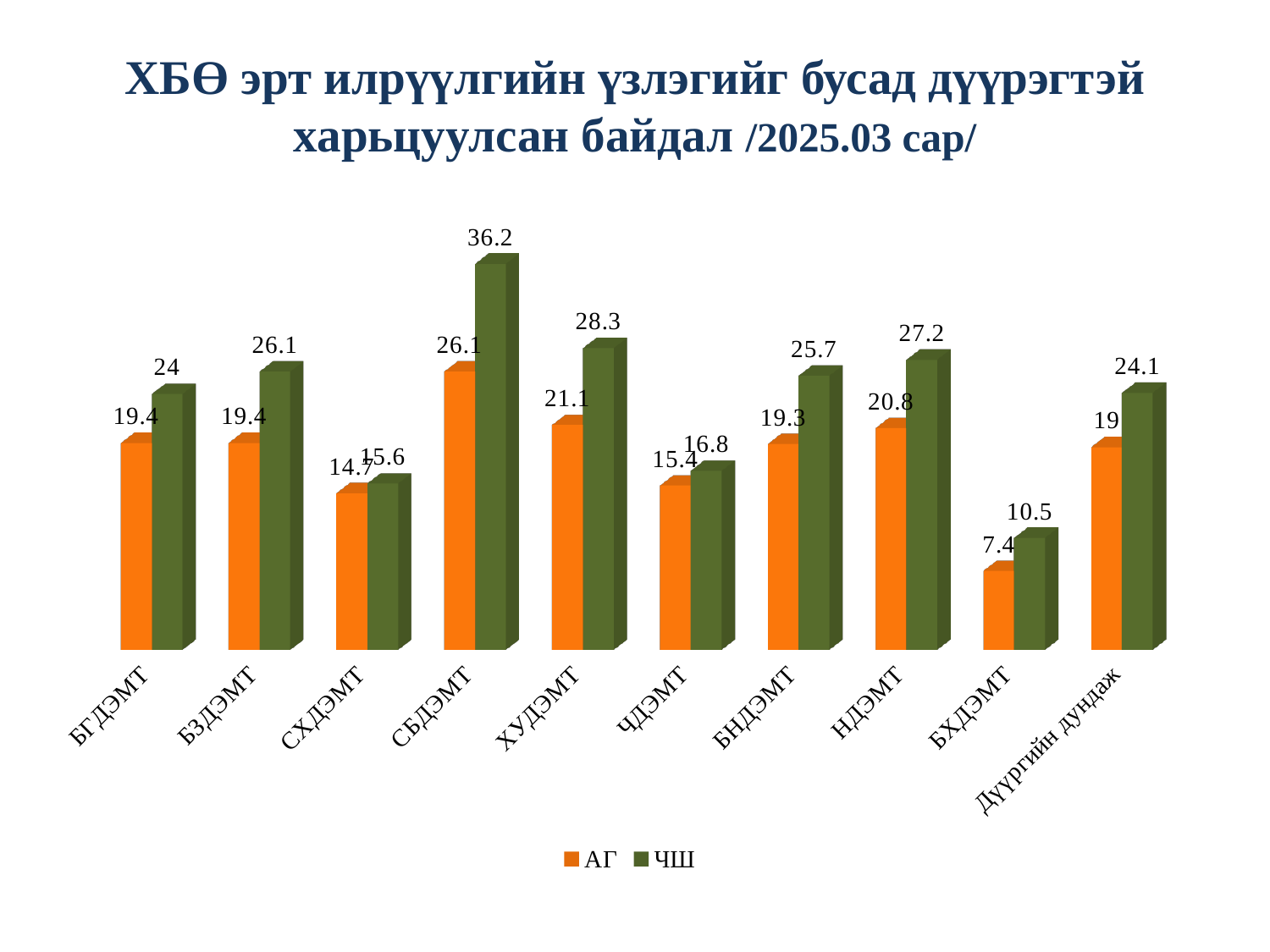
What is the difference between the ЧШ values for ХУДЭМТ and БХДЭМТ? 17.8 Which series is shown in orange? АГ What is the ЧШ value for СБДЭМТ? 36.2 What is the difference between the ЧШ and АГ values for СБДЭМТ? 10.1 Which is larger, the АГ value for ХУДЭМТ or the АГ value for БНДЭМТ? ХУДЭМТ Which category has the highest ЧШ value? СБДЭМТ Which category has the lowest АГ value? БХДЭМТ What is the ЧШ value for Дүүргийн дундаж? 24.1 What kind of chart is shown on the slide? Bar chart How many categories are shown on the x axis? 10 How many series does the legend list? 2 What is the АГ value for НДЭМТ? 20.8